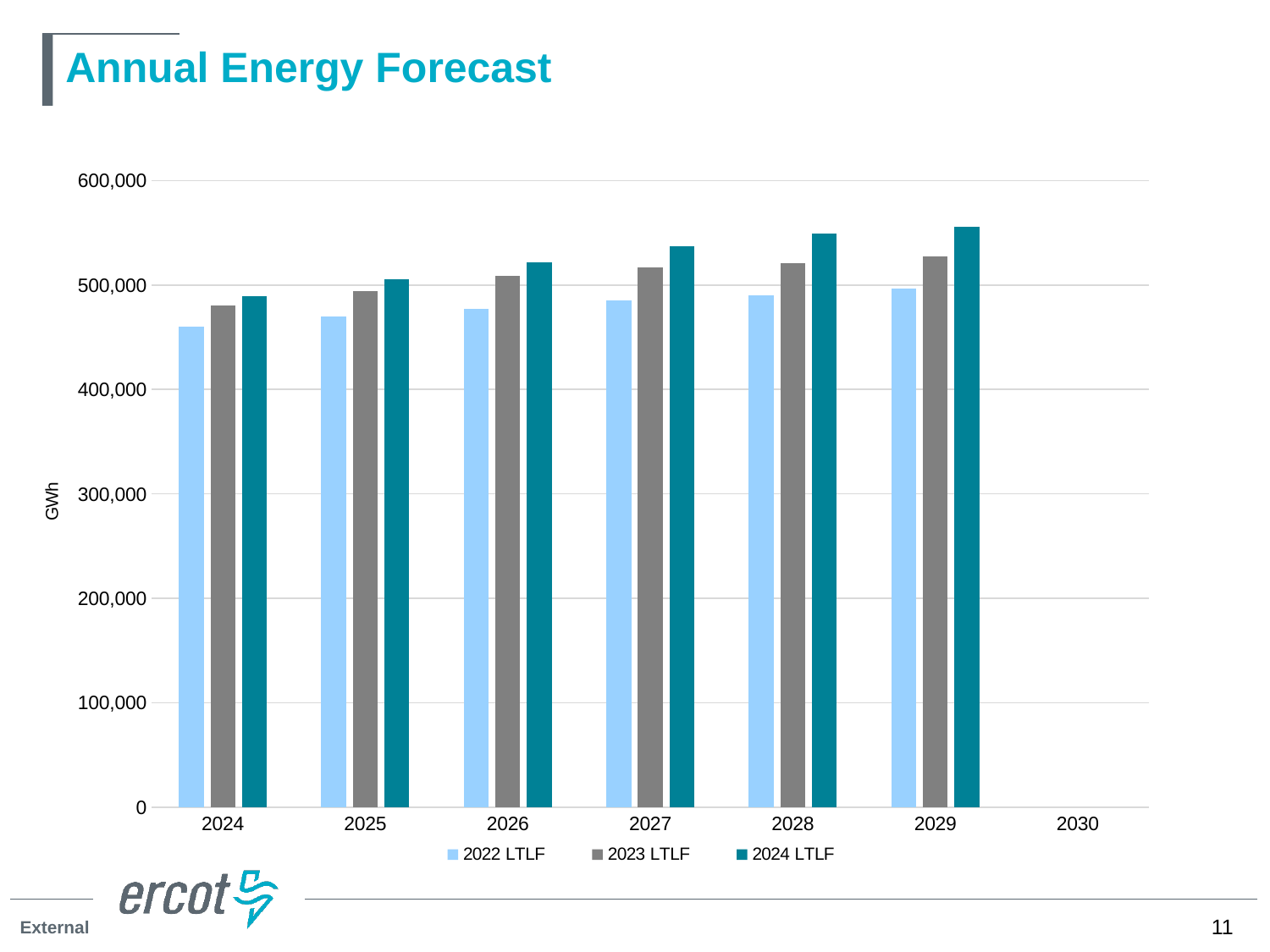
Do the 2024 LTLF values rise or fall from 2024 to 2029? Rise For the 2022 LTLF series, which year has the lowest value? 2024 In 2029, which is larger: the 2022 LTLF value or the 2024 LTLF value? 2024 LTLF Is the 2024 LTLF value for 2029 greater or less than 500,000? greater How many series does the legend list? 3 Is the 2023 LTLF value for 2029 greater or less than 500,000? greater How many years on the x axis have bars plotted? 6 Is the 2022 LTLF value for 2024 greater or less than 500,000? less What are the three series listed in the legend? 2022 LTLF, 2023 LTLF, 2024 LTLF What type of chart is shown on the slide? Bar chart For the 2024 LTLF series, which year has the highest value? 2029 What unit is shown on the y-axis label? GWh